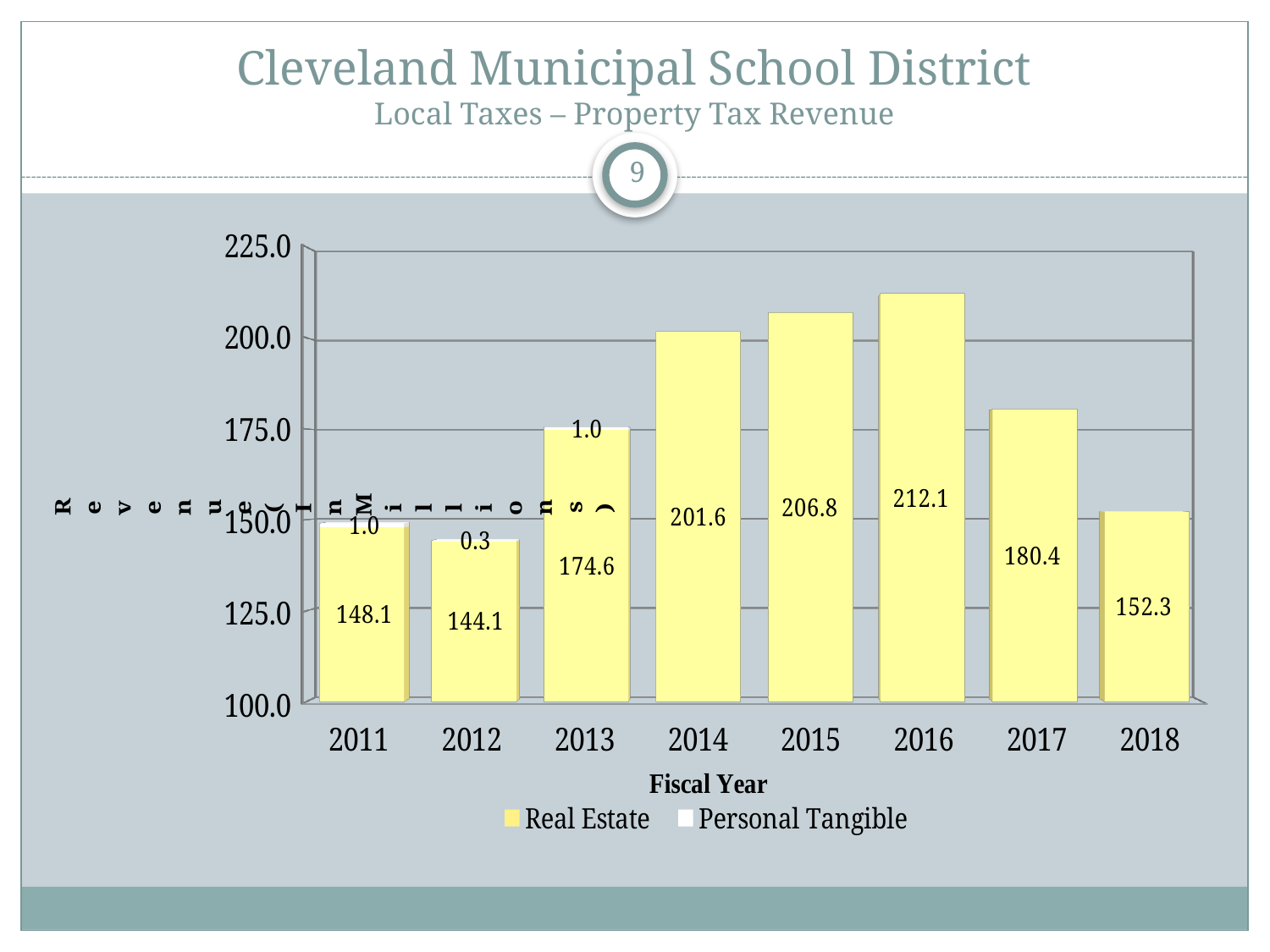
Is the Real Estate revenue larger in 2014 or in 2018? 2014 What is the Personal Tangible value shown for fiscal year 2012? 0.3 How many fiscal years are shown on the x axis? 8 What is the total of the stacked bar for fiscal year 2011 (Real Estate plus Personal Tangible)? 149.1 Which fiscal year has the highest Real Estate revenue? 2016 How many series does the legend list? 2 What is the difference between the Real Estate revenue in 2016 and in 2017? 31.7 What kind of chart is shown on the slide? bar chart What is the Real Estate property tax revenue for fiscal year 2012? 144.1 Is the Real Estate revenue for 2013 greater or less than 175.0? less What is the Real Estate property tax revenue for fiscal year 2016? 212.1 Which fiscal year has the lowest Real Estate revenue? 2012